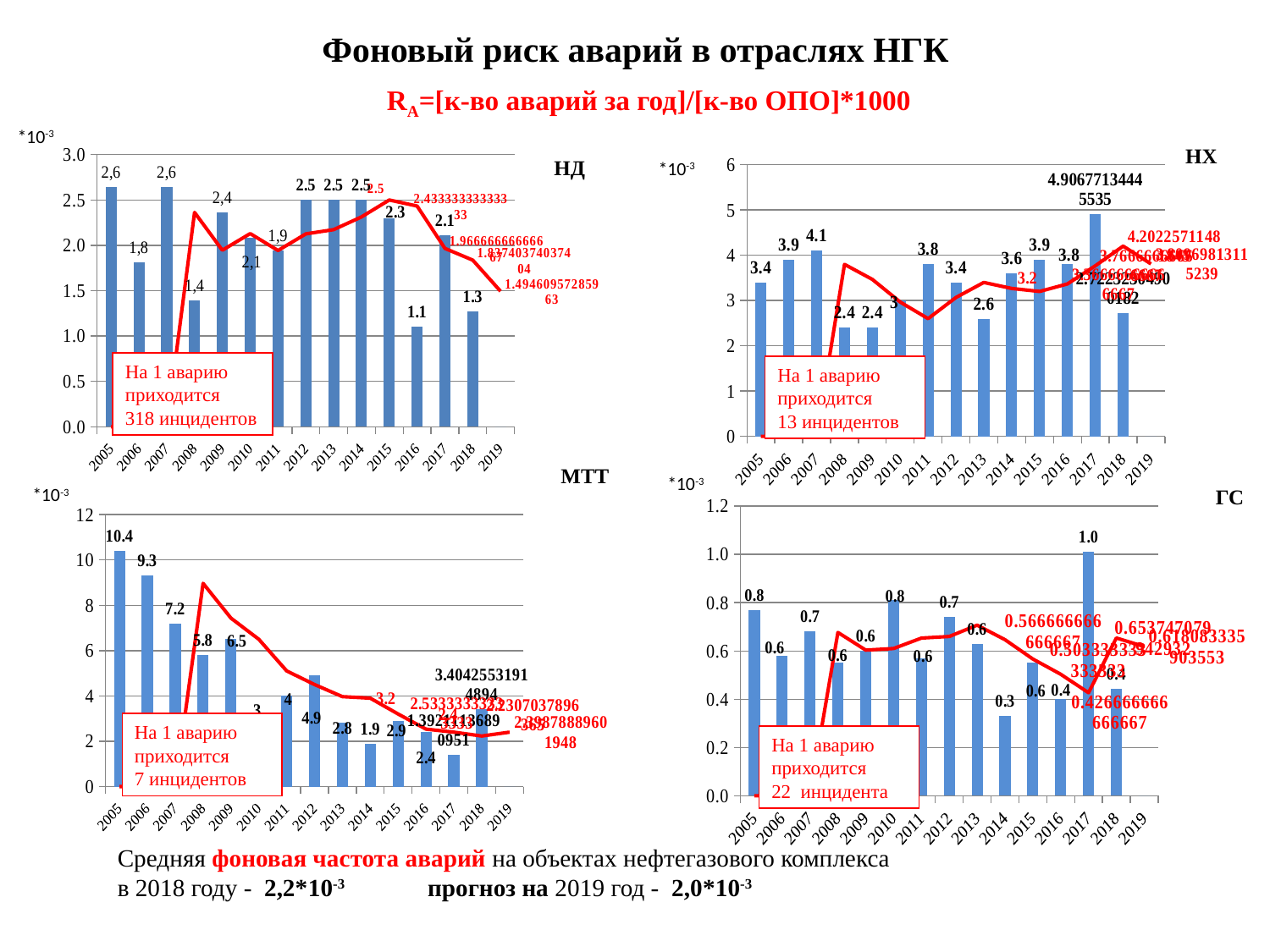
In the ГС chart (bottom right), which year has the lowest bar? 2014 In the НХ chart (top right), is the value for 2018 greater or less than 3? less In the МТТ chart (bottom left), what is the value for 2005? 10.4 In the НД chart (top left), which year has the lowest bar? 2016 How many charts are shown on the slide? 4 In the МТТ chart (bottom left), do the bar values generally rise or fall from 2005 to 2018? fall In the НД chart (top left), which is larger, the value for 2009 or the value for 2011? 2009 In the НХ chart (top right), which year has the highest bar? 2017 In the НХ chart (top right), what is the value for 2007? 4.1 In the НД chart (top left), what is the difference between the values for 2012 and 2018? 1.2 In the ГС chart (bottom right), what is the difference between the values for 2017 and 2014? 0.7 In the НД chart (top left), what is the value for 2016? 1.1